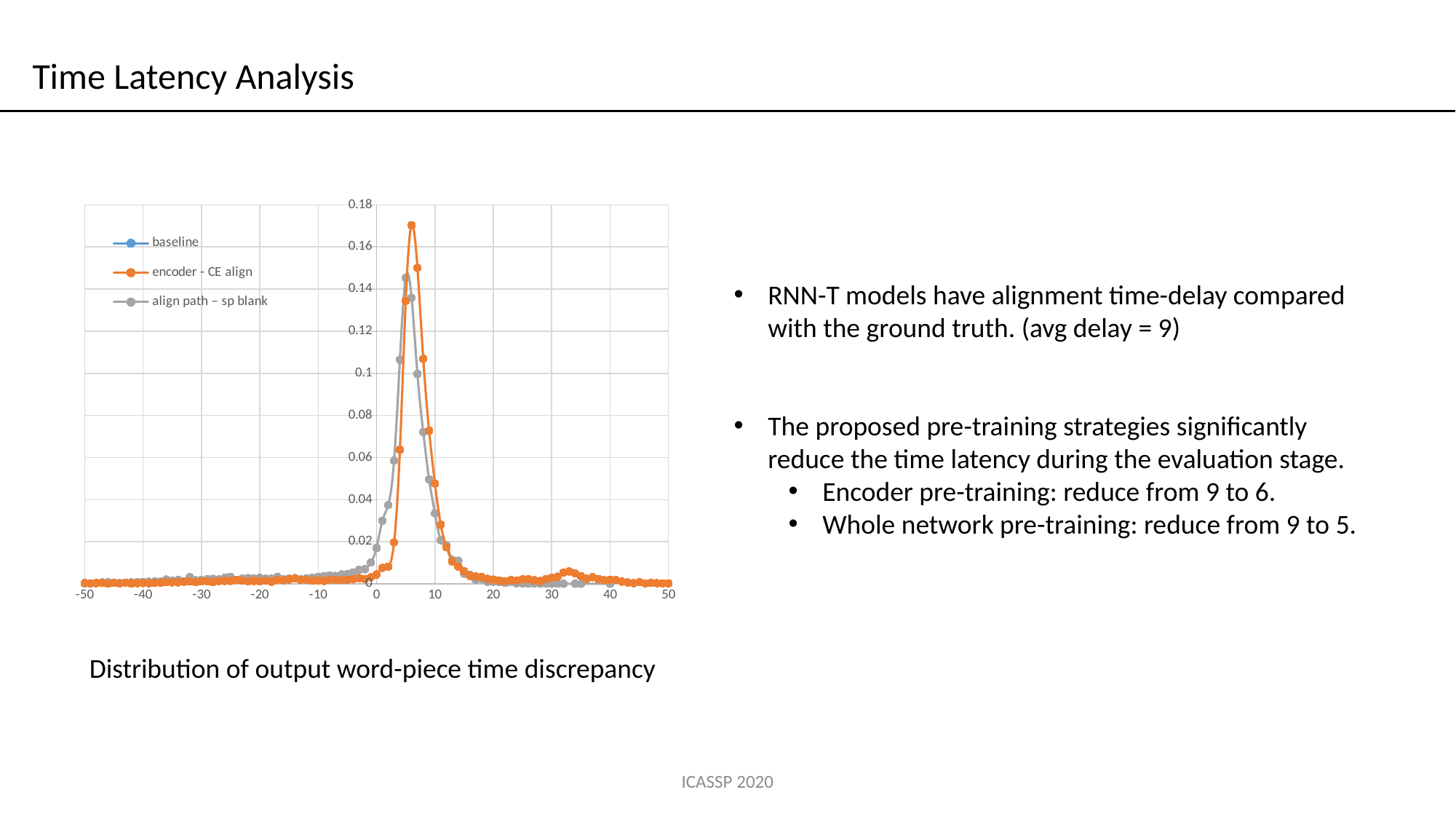
Is the value of the 'encoder - CE align' series at x = -50 greater or less than 0.02? less What kind of chart is shown on the slide? line chart Between x = 10 and x = 20, do the values of the 'encoder - CE align' series rise or fall? fall What is the range of the chart's x axis, from its lowest to its highest tick? -50 to 50 Is the value of the 'align path – sp blank' series at x = 0 greater or less than 0.04? less How many series does the chart legend list? 3 What colour is the line for the 'encoder - CE align' series? orange Is the peak value of the 'encoder - CE align' series greater or less than 0.16? greater What is the highest value shown on the chart's y axis? 0.18 Which series reaches a higher peak, 'encoder - CE align' or 'align path – sp blank'? encoder - CE align